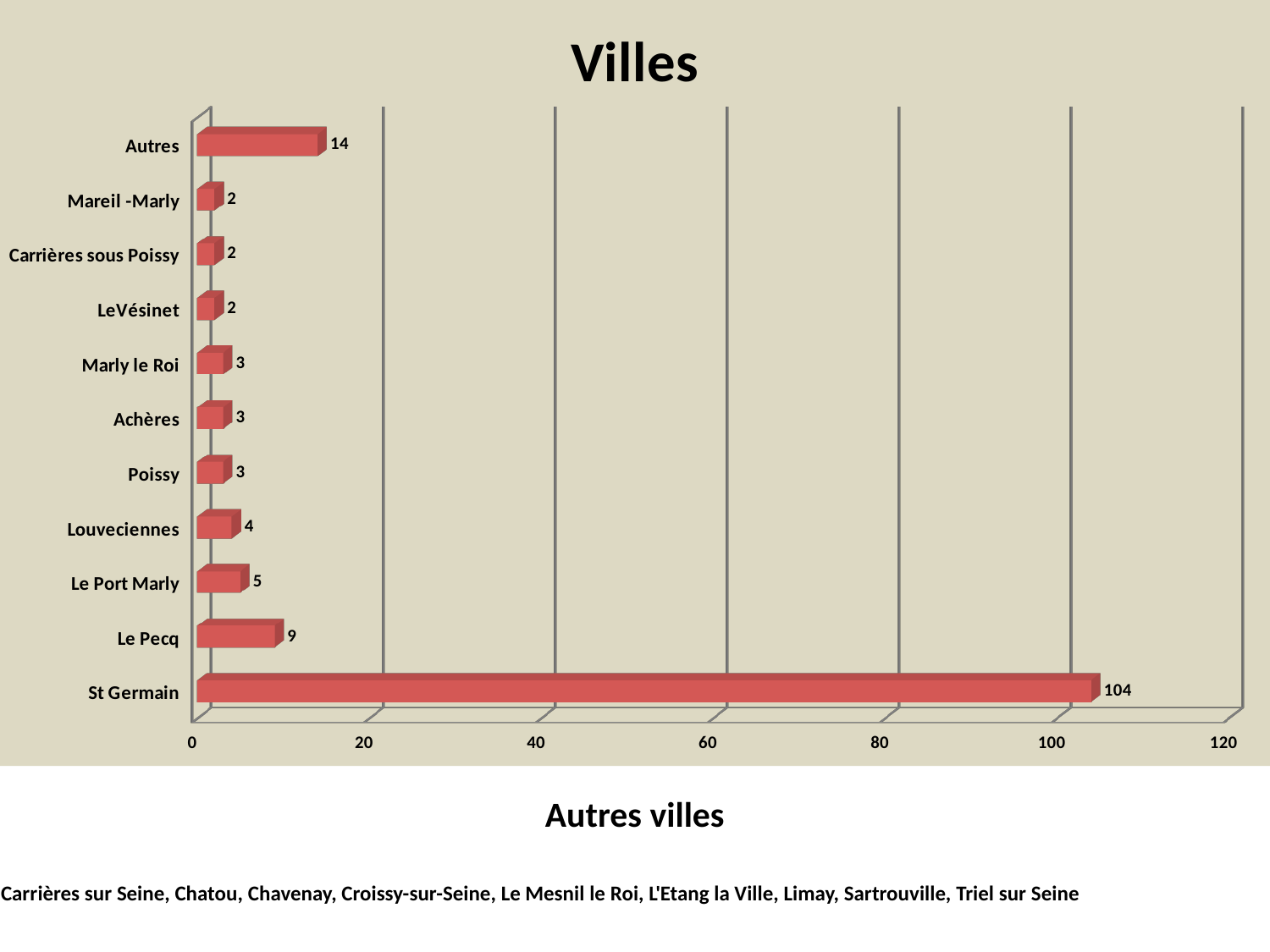
Which is larger, the value for Le Pecq or the value for Le Port Marly? Le Pecq Is the value for St Germain greater or less than 100? greater What is the value for St Germain? 104 Which category has the highest value? St Germain What is the value for Le Port Marly? 5 What is the value for Autres? 14 What is the difference between the values for St Germain and Le Pecq? 95 What is the value for Le Pecq? 9 What is the difference between the values for Autres and Louveciennes? 10 What is the title of the chart? Villes What kind of chart is shown on the slide? bar chart How many categories are shown in the chart? 11